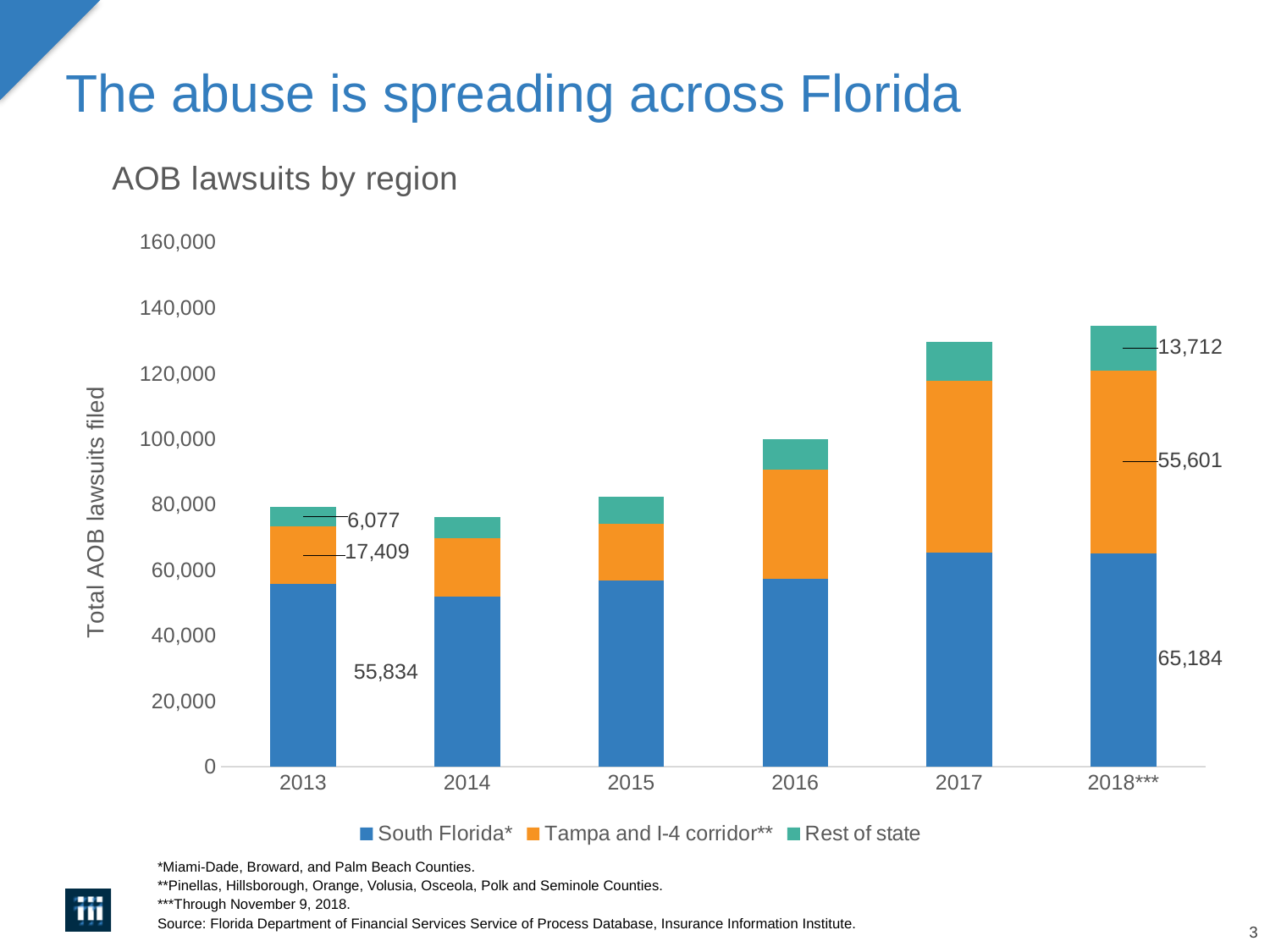
What is the total of the stacked bar for 2013? 79,320 What is the value for Rest of state in 2013? 6,077 Is the total for 2016 greater or less than 80,000? greater What is the value for Rest of state in 2018? 13,712 What kind of chart is shown on the slide? Stacked bar chart Which is larger in 2018: the Tampa and I-4 corridor value or the Rest of state value? Tampa and I-4 corridor How many series does the legend list? 3 What is the value for South Florida in 2013? 55,834 What is the value for Tampa and I-4 corridor in 2018? 55,601 What is the difference between the South Florida values in 2018 and 2013? 9,350 Which year has the highest total AOB lawsuits filed? 2018*** How many years are shown on the x axis? 6